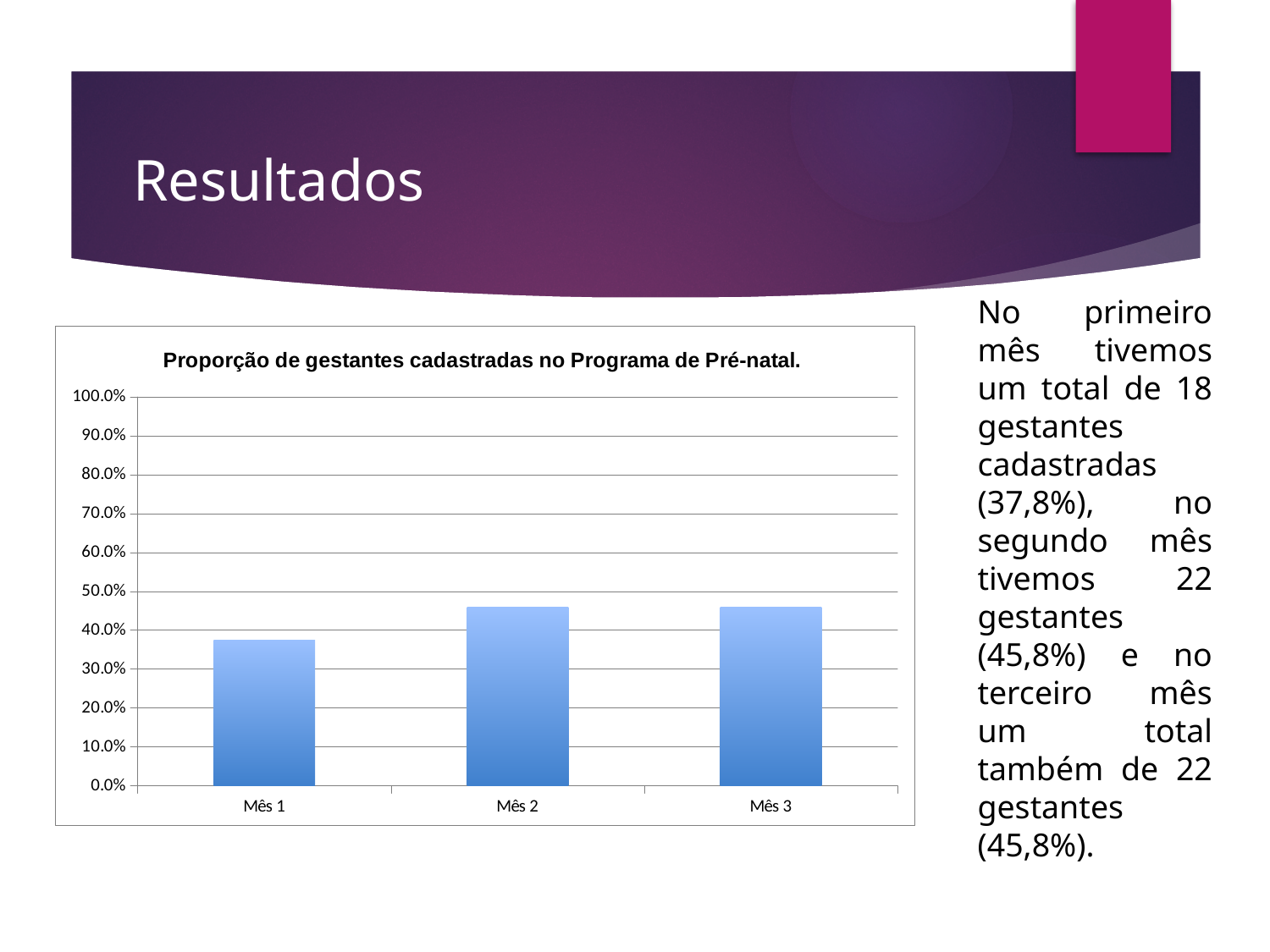
Is the value for Mês 2 greater or less than 40.0%? greater Is the value for Mês 1 greater or less than 30.0%? greater What kind of chart is shown on the slide? bar chart Is the value for Mês 3 greater or less than 50.0%? less How many categories (months) are plotted on the x axis? 3 What is the highest value shown on the y axis? 100.0% Do the values rise or fall from Mês 1 to Mês 2? rise Which is larger, the value for Mês 1 or the value for Mês 2? Mês 2 Which month has the lowest proportion of registered pregnant women? Mês 1 What is the title of the chart? Proporção de gestantes cadastradas no Programa de Pré-natal. Which is larger, the value for Mês 3 or the value for Mês 1? Mês 3